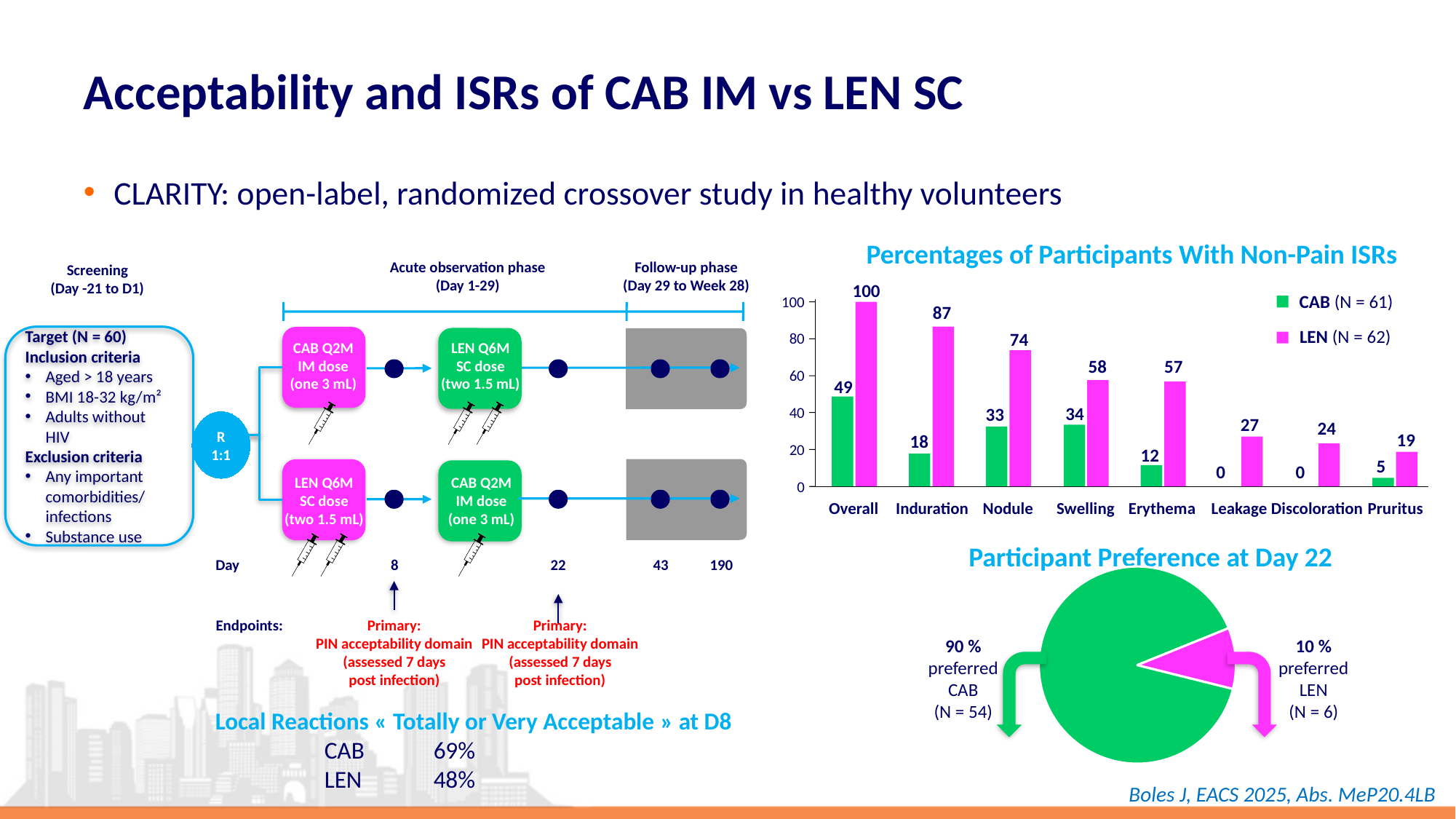
In the 'Percentages of Participants With Non-Pain ISRs' chart, how many categories are shown on the x axis? 8 In the 'Percentages of Participants With Non-Pain ISRs' chart, what is the difference between the LEN and CAB values for Swelling? 24 In the 'Percentages of Participants With Non-Pain ISRs' chart, which category has the lowest LEN value? Pruritus What kind of chart is 'Percentages of Participants With Non-Pain ISRs'? Bar chart In the 'Percentages of Participants With Non-Pain ISRs' chart, what is the value for LEN in the Nodule category? 74 In the 'Participant Preference at Day 22' pie chart, what share of participants preferred CAB? 90 % In the 'Percentages of Participants With Non-Pain ISRs' chart, what is the value for LEN in the Overall category? 100 In the 'Percentages of Participants With Non-Pain ISRs' chart, which is larger for Erythema, CAB or LEN? LEN In the 'Percentages of Participants With Non-Pain ISRs' chart, what is the value for CAB in the Induration category? 18 In the 'Participant Preference at Day 22' pie chart, how many participants preferred LEN? N = 6 In the 'Percentages of Participants With Non-Pain ISRs' chart, how many series does the legend list? 2 In the 'Percentages of Participants With Non-Pain ISRs' chart, what is the CAB value for Leakage? 0